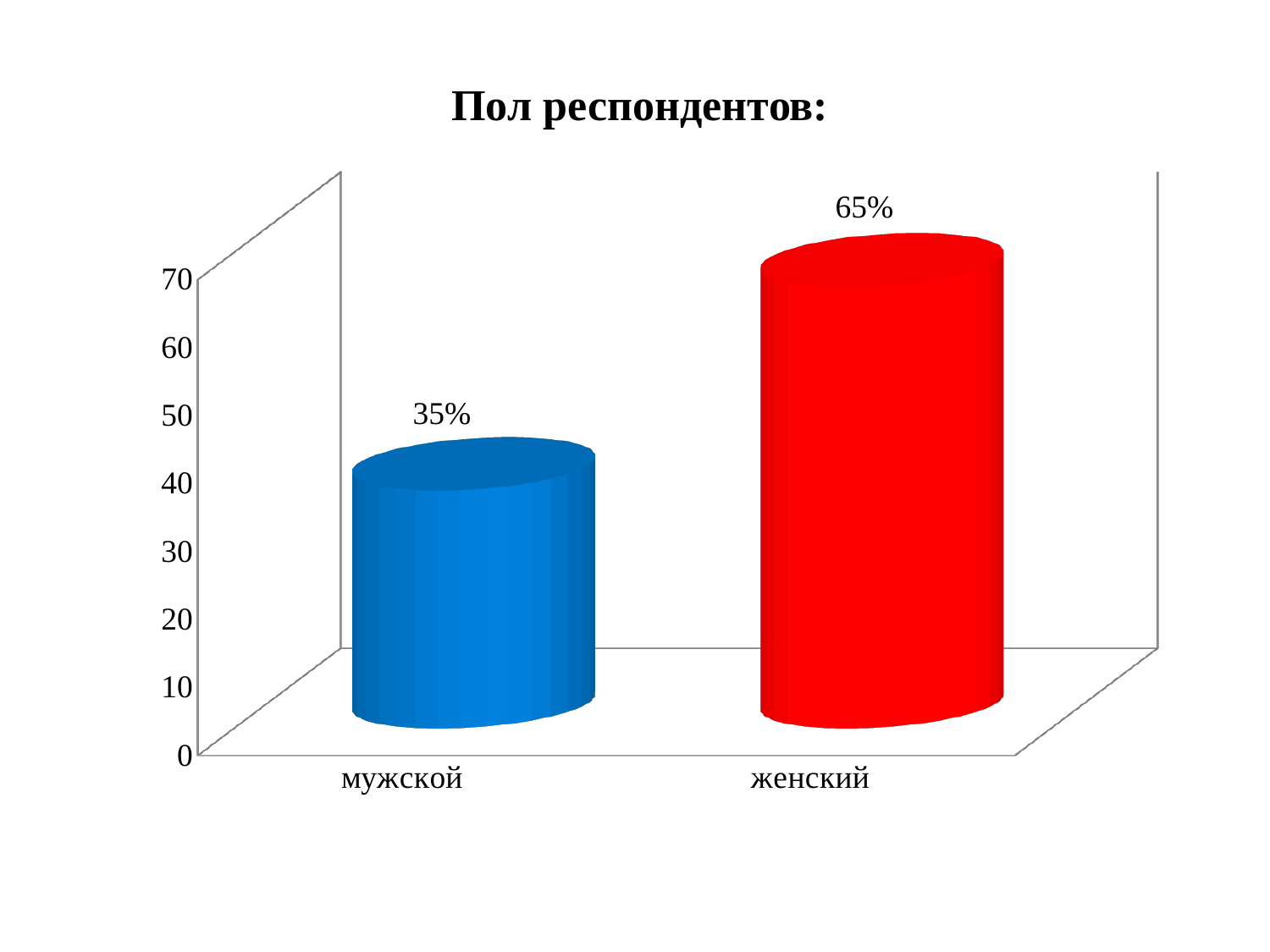
Is the value for женский greater or less than 60? greater Is the value for мужской greater or less than 40? less How many categories are shown on the chart? 2 Which category has the highest value? женский What is the difference between the values for женский and мужской? 30% Which category has the lowest value? мужской What is the title of the chart? Пол респондентов: What is the value for мужской? 35% Which is larger, the value for мужской or the value for женский? женский What kind of chart is shown on the slide? bar chart What colour is the bar for женский? red What is the value for женский? 65%